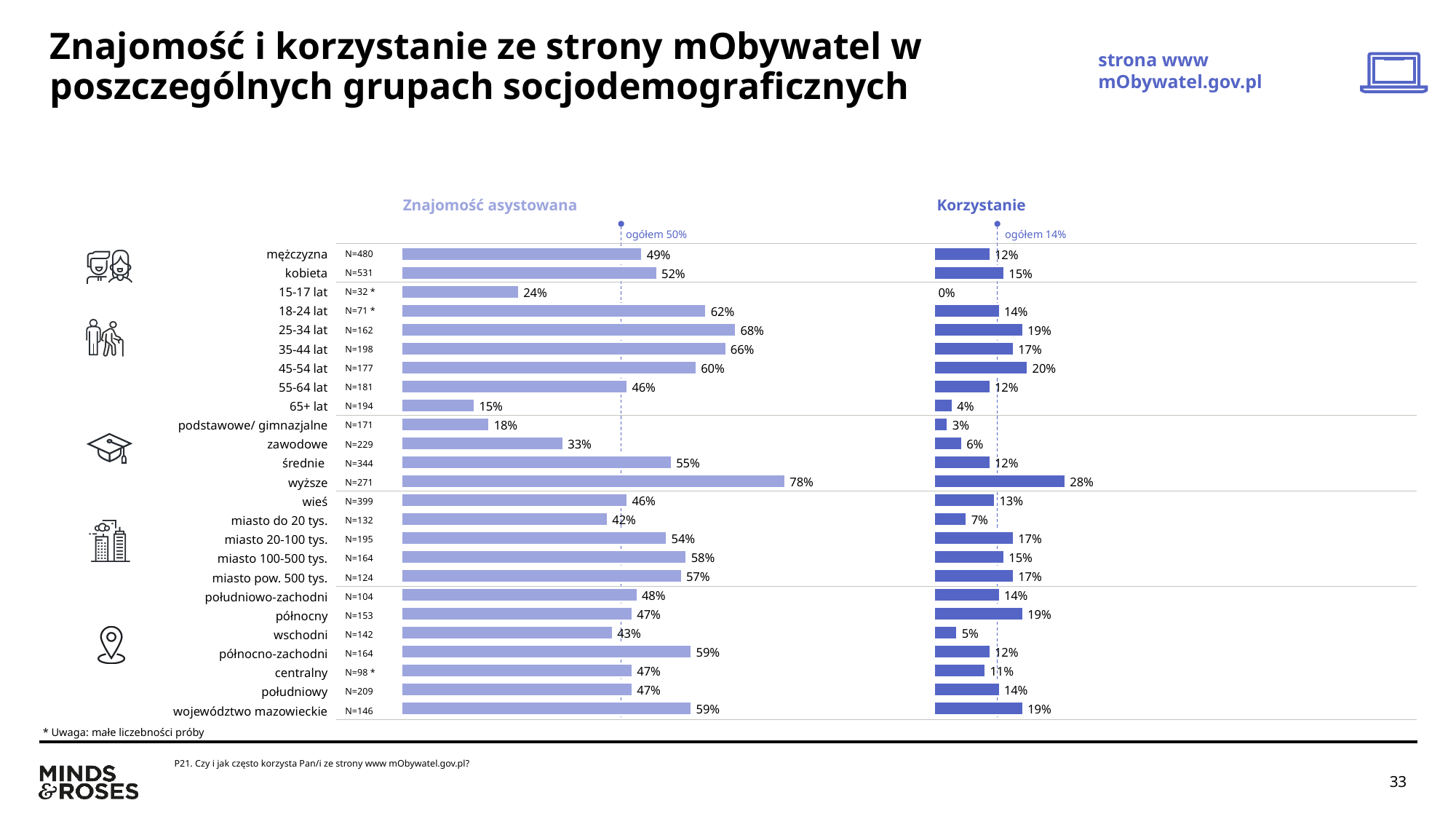
In the 'Korzystanie' chart, what is the overall (ogółem) value marked by the reference line? 14% In the 'Korzystanie' chart, what is the value for 45-54 lat? 20% How many categories are plotted in the 'Znajomość asystowana' chart? 25 In the 'Znajomość asystowana' chart, what is the value for wyższe? 78% In the 'Korzystanie' chart, which category has the lowest value? 15-17 lat In the 'Znajomość asystowana' chart, which category has the highest value? wyższe In the 'Znajomość asystowana' chart, which category has the lowest value? 65+ lat In the 'Znajomość asystowana' chart, what is the difference between kobieta and mężczyzna? 3 percentage points In the 'Korzystanie' chart, which category has the highest value? wyższe In the 'Znajomość asystowana' chart, what is the overall (ogółem) value marked by the reference line? 50% What kind of chart is the 'Korzystanie' chart? bar chart In the 'Korzystanie' chart, which is larger: the value for wieś or the value for miasto do 20 tys.? wieś